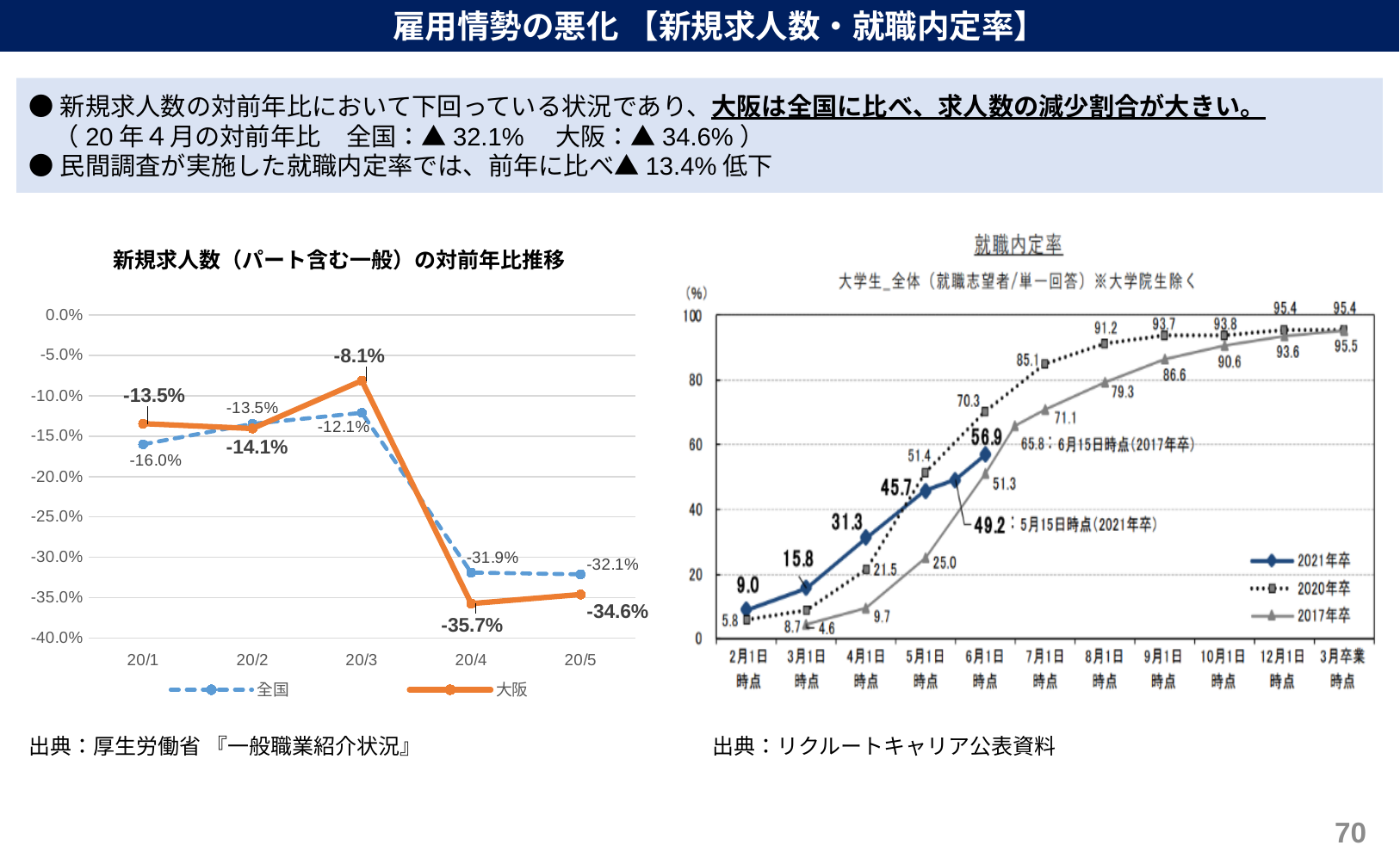
In the left chart (新規求人数の対前年比推移), what is the difference between the 全国 and 大阪 values at 20/5? 2.5 percentage points In the left chart (新規求人数の対前年比推移), which series has the higher value at 20/3, 全国 or 大阪? 大阪 In the right chart (就職内定率), what is the value for 2021年卒 at 6月1日時点? 56.9 What kind of chart is the left chart (新規求人数の対前年比推移)? Line chart In the left chart (新規求人数の対前年比推移), how many series does the legend list? 2 In the right chart (就職内定率), what is the value for 2020年卒 at 7月1日時点? 85.1 In the left chart (新規求人数の対前年比推移), at which month is the 大阪 value lowest? 20/4 In the right chart (就職内定率), how many series does the legend list? 3 In the right chart (就職内定率), do the values for 2017年卒 rise or fall from 2月1日時点 to 3月卒業時点? Rise In the left chart (新規求人数の対前年比推移), what is the value for 大阪 at 20/4? -35.7% In the left chart (新規求人数の対前年比推移), what is the value for 全国 at 20/1? -16.0% In the left chart (新規求人数の対前年比推移), what is the value for 大阪 at 20/3? -8.1%